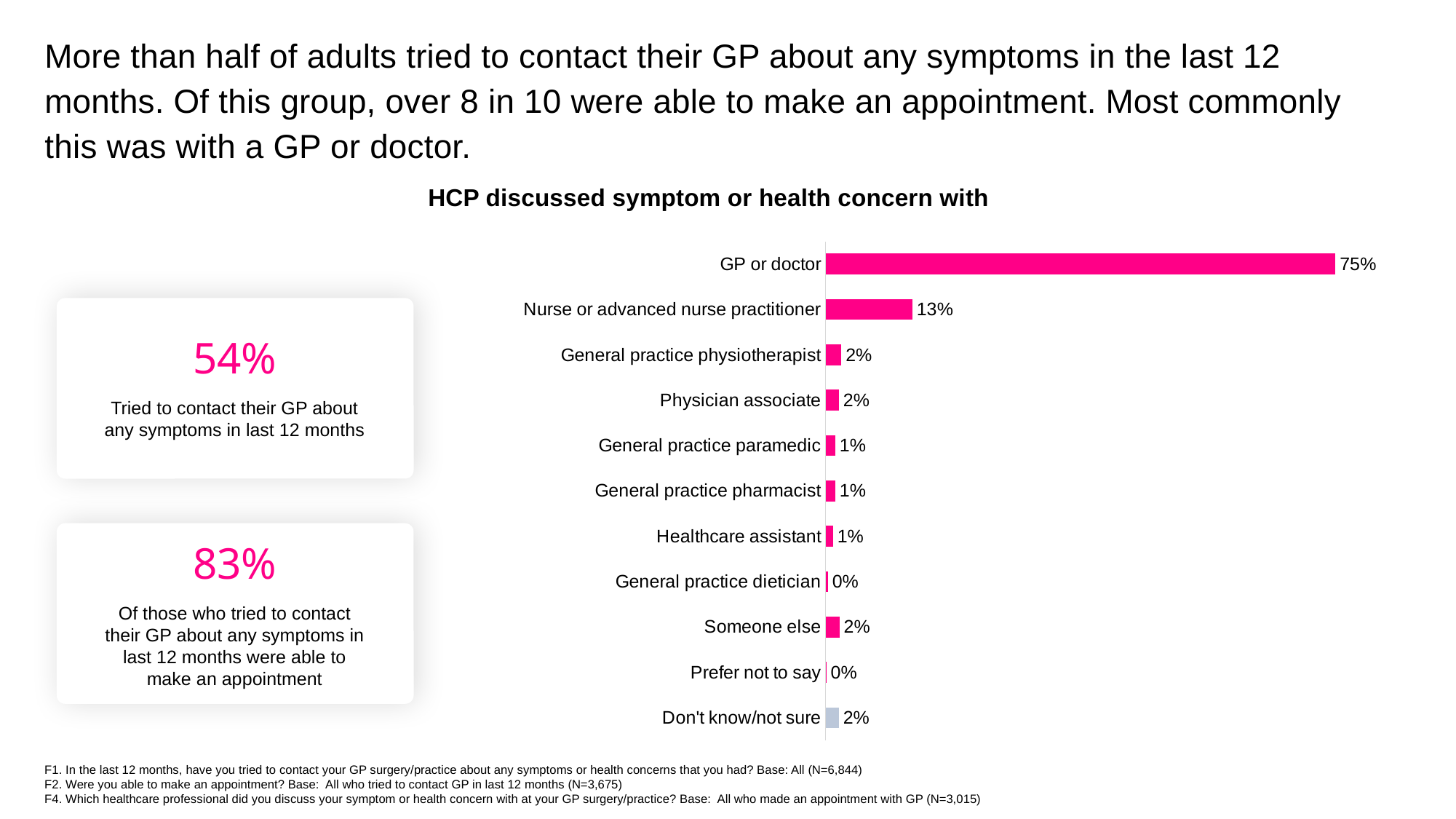
What is the value for Nurse or advanced nurse practitioner? 13% What is the value for General practice dietician? 0% What is the difference between the values for GP or doctor and Nurse or advanced nurse practitioner? 62 percentage points Which is larger, the value for Nurse or advanced nurse practitioner or the value for General practice physiotherapist? Nurse or advanced nurse practitioner How many categories are shown in the chart? 11 What percentage discussed their symptom or health concern with a GP or doctor? 75% What is the value for General practice paramedic? 1% Which bar in the chart is coloured grey rather than pink? Don't know/not sure What is the title of the chart? HCP discussed symptom or health concern with What is the value for Don't know/not sure? 2% What kind of chart is shown on the slide? Bar chart Which healthcare professional has the highest percentage in the chart? GP or doctor